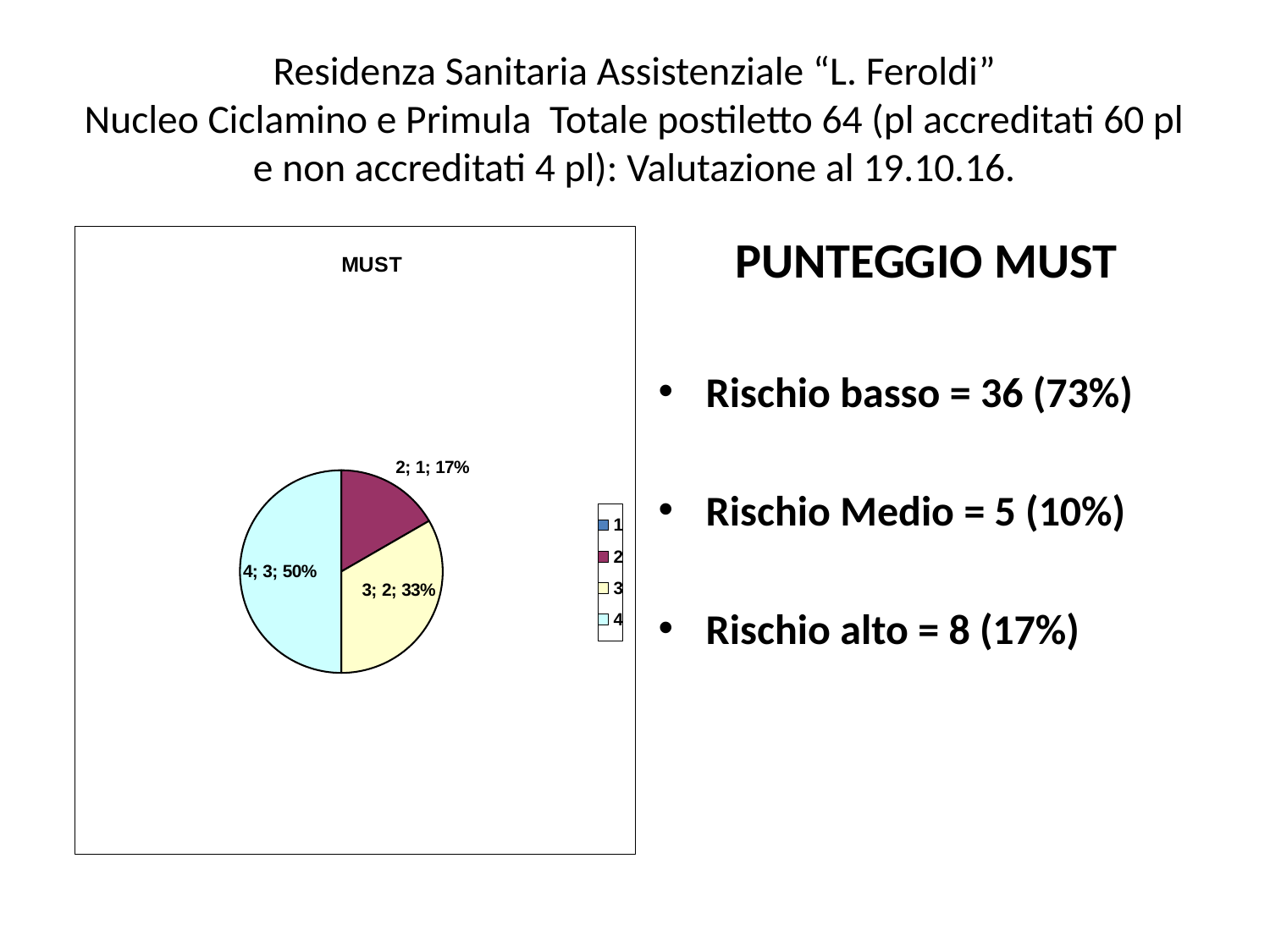
How many entries does the chart's legend list? 4 What is the value shown for category 2 in the pie chart? 1 What is the difference between the values for category 4 and category 2? 2 Which category has the largest slice of the pie? 4 Which of the labelled slices is the smallest? 2 What is the title of the chart? MUST What type of chart is shown on the slide? pie chart What is the value shown for category 4 in the pie chart? 3 What percentage share of the pie does category 3 have? 33% What percentage share of the pie does category 2 have? 17% What percentage share of the pie does category 4 have? 50% Which has a larger share of the pie, category 3 or category 2? 3